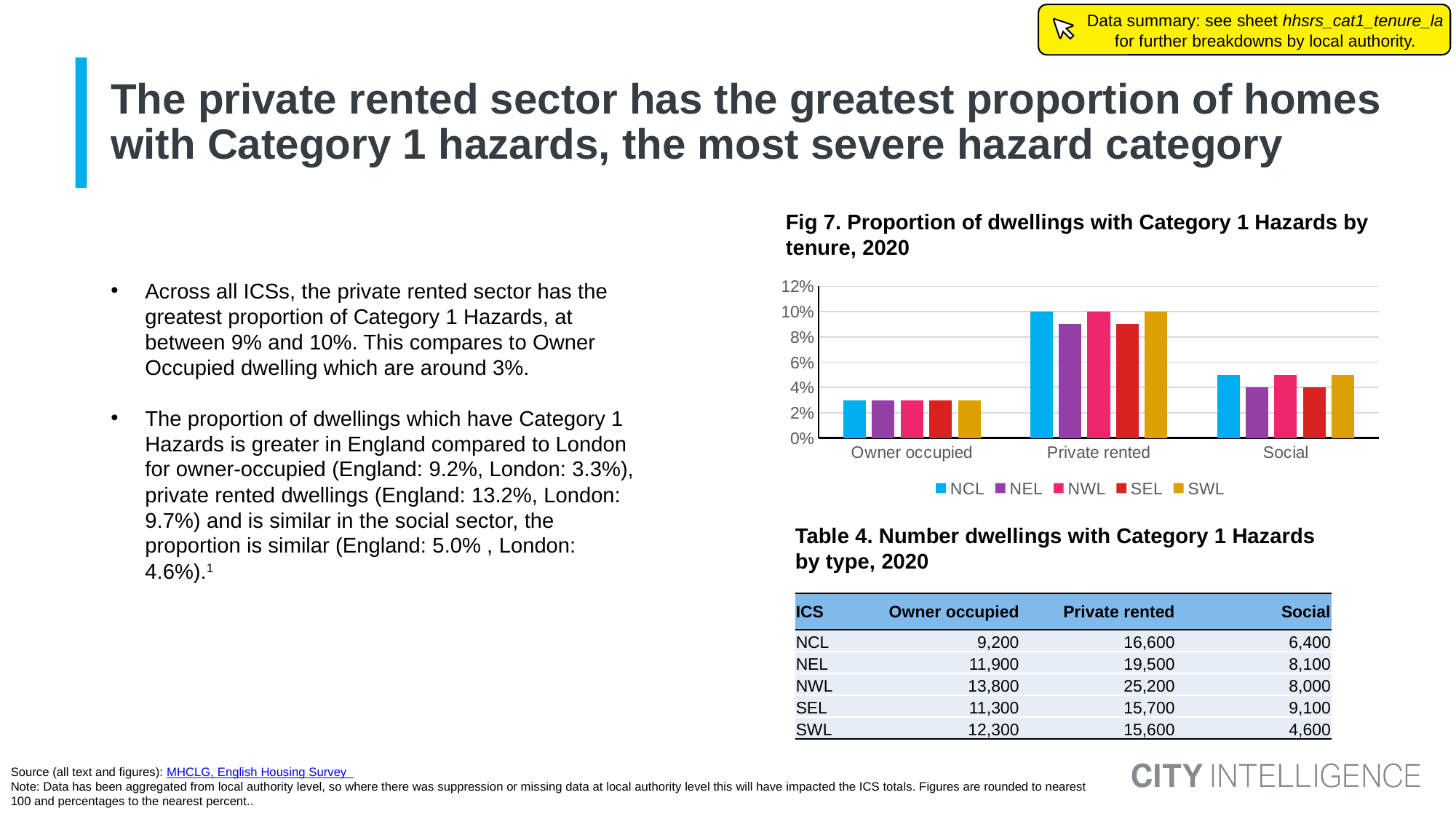
In Fig 7, which is larger for NWL: the Private rented value or the Social value? Private rented In Fig 7, which tenure category has the highest values across all ICSs? Private rented How many series does the legend of Fig 7 list? 5 In Fig 7, is the value for NCL in the Owner occupied category greater or less than 4%? less What kind of chart is Fig 7? bar chart In Fig 7, is the value for NEL in the Private rented category greater or less than 8%? greater In Fig 7, which tenure category has the lowest values across all ICSs? Owner occupied In Fig 7, what is the value for NCL in the Private rented category? 10% How many tenure categories are shown on the x axis of Fig 7? 3 In Fig 7, what is the value for NEL in the Social category? 4% In Fig 7, what is the value for SEL in the Social category? 4% In Fig 7, what is the value for SWL in the Private rented category? 10%